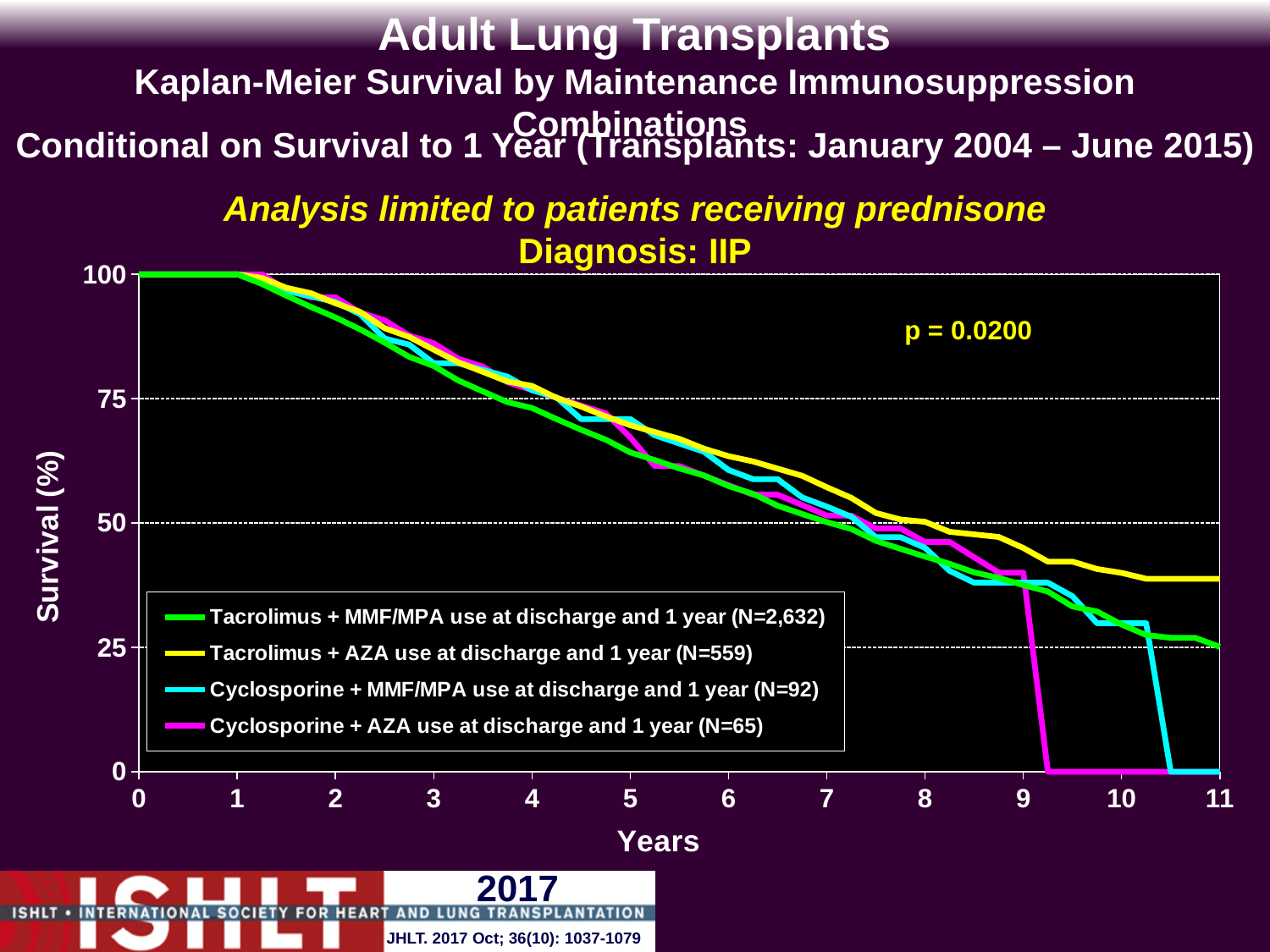
How many series does the legend list? 4 At year 10, which is larger: survival for Tacrolimus + AZA or for Tacrolimus + MMF/MPA? Tacrolimus + AZA What is the N for the Cyclosporine + AZA use at discharge and 1 year series? 65 Is the survival for Tacrolimus + MMF/MPA at year 5 greater or less than 50? greater Which series has the highest survival at year 11? Tacrolimus + AZA use at discharge and 1 year Is the survival for Tacrolimus + AZA at year 11 greater or less than 25? greater What is the p-value printed on the chart? p = 0.0200 Which series is the first to drop to 0% survival? Cyclosporine + AZA use at discharge and 1 year What is the N for the Tacrolimus + MMF/MPA use at discharge and 1 year series? 2,632 What is the label of the y-axis? Survival (%) What kind of chart is shown on the slide? Line chart Do the survival curves rise or fall as years increase? Fall